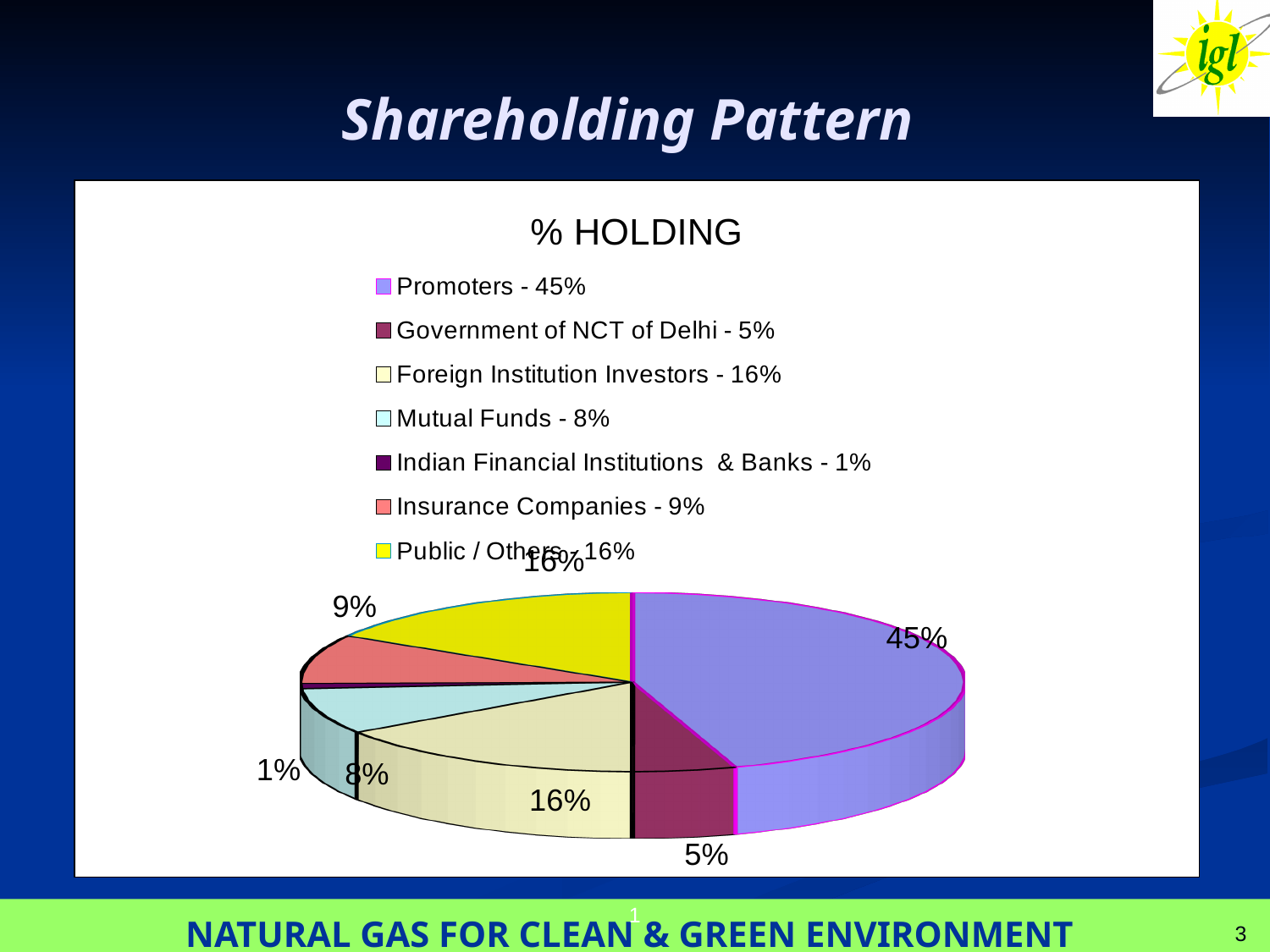
What share of holding do Promoters have? 45% Which has a larger share of holding, Mutual Funds or Insurance Companies? Insurance Companies What is the title of the chart? % HOLDING What share of holding do Mutual Funds have? 8% What share of holding do Insurance Companies have? 9% What type of chart is shown on the slide? pie chart What is the difference between the Promoters' share and the Foreign Institution Investors' share? 29% Which category has the largest share of holding? Promoters Which category has the smallest share of holding? Indian Financial Institutions & Banks Which two categories each hold 16%? Foreign Institution Investors and Public / Others What share of holding does the Government of NCT of Delhi have? 5% How many categories does the legend list? 7